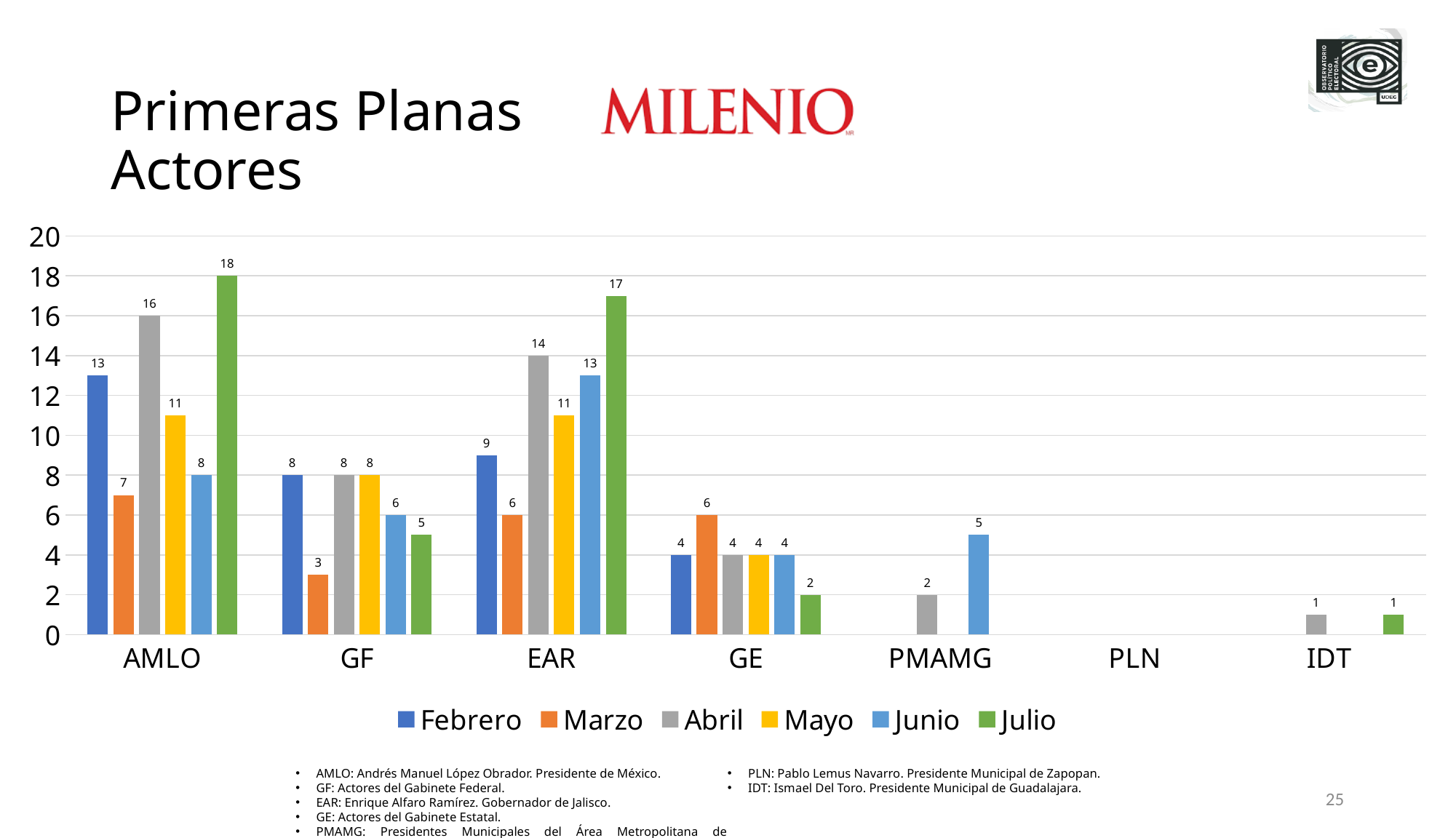
What kind of chart is shown on the slide? Bar chart How many series does the legend list? 6 What is the value for EAR in Abril? 14 What is the value for AMLO in Julio? 18 Which is larger, the Junio value for EAR or the Junio value for AMLO? EAR Which category has the lowest Marzo value among those with a Marzo bar? GF What is the difference between the Abril value for AMLO and the Abril value for EAR? 2 How many categories are shown on the x axis? 7 Which series is shown in green in the legend? Julio What is the value for PMAMG in Junio? 5 Which category has the highest Julio value? AMLO What is the value for GF in Marzo? 3